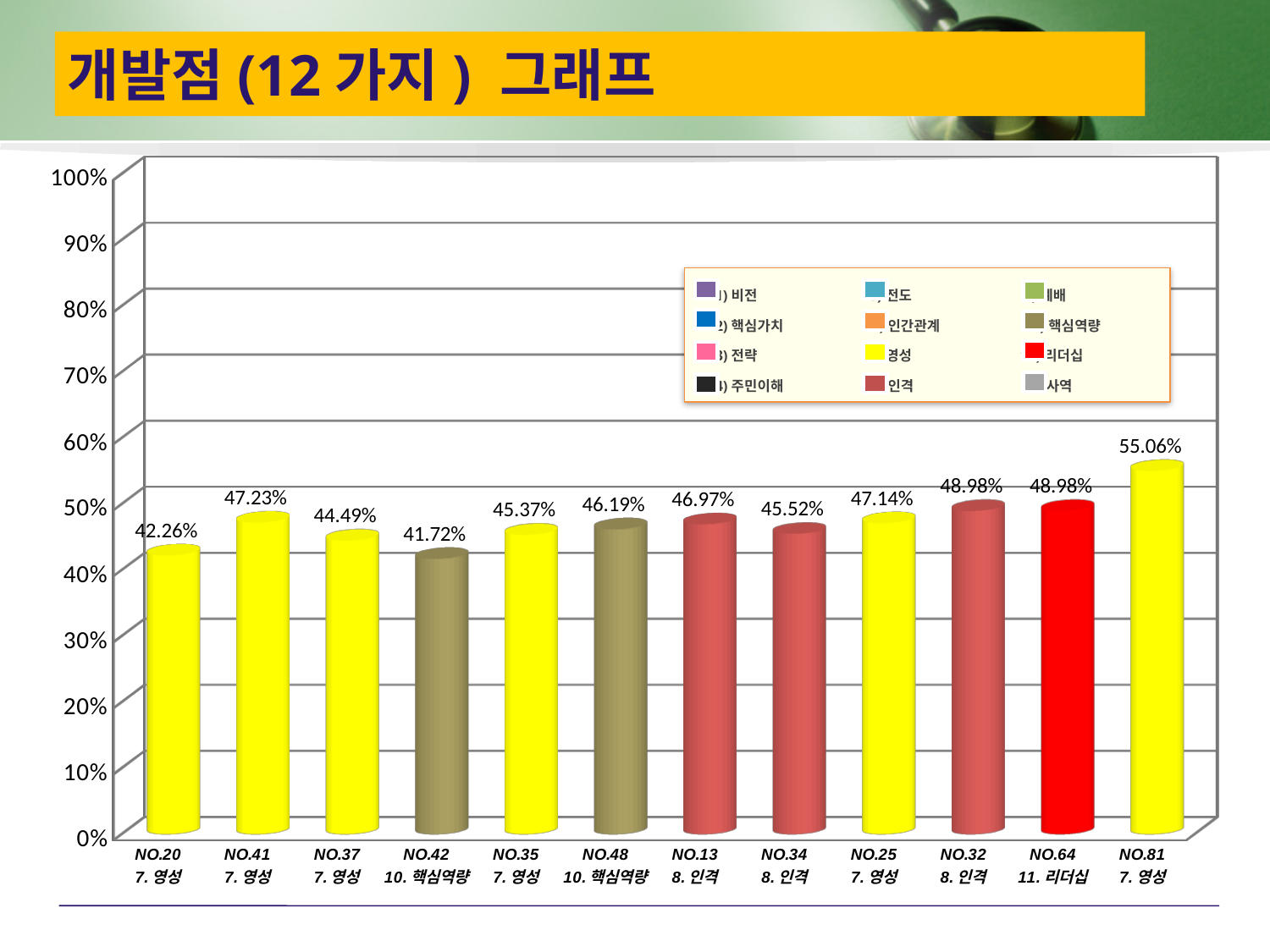
What is the value shown for NO.42 (10. 핵심역량)? 41.72% What is the difference between the values for NO.81 and NO.20? 12.80% What kind of chart is shown on the slide? bar chart Which bar has the lowest value? NO.42 (10. 핵심역량) How many entries does the legend list? 12 Which is larger, the value for NO.41 or the value for NO.37? NO.41 What is the value shown for NO.20 (7. 영성)? 42.26% What is the title of the slide? 개발점 (12 가지 ) 그래프 What is the value shown for NO.64 (11. 리더십)? 48.98% How many bars are plotted in the chart? 12 Is the value for NO.81 greater or less than 50%? greater Which bar has the highest value? NO.81 (7. 영성)